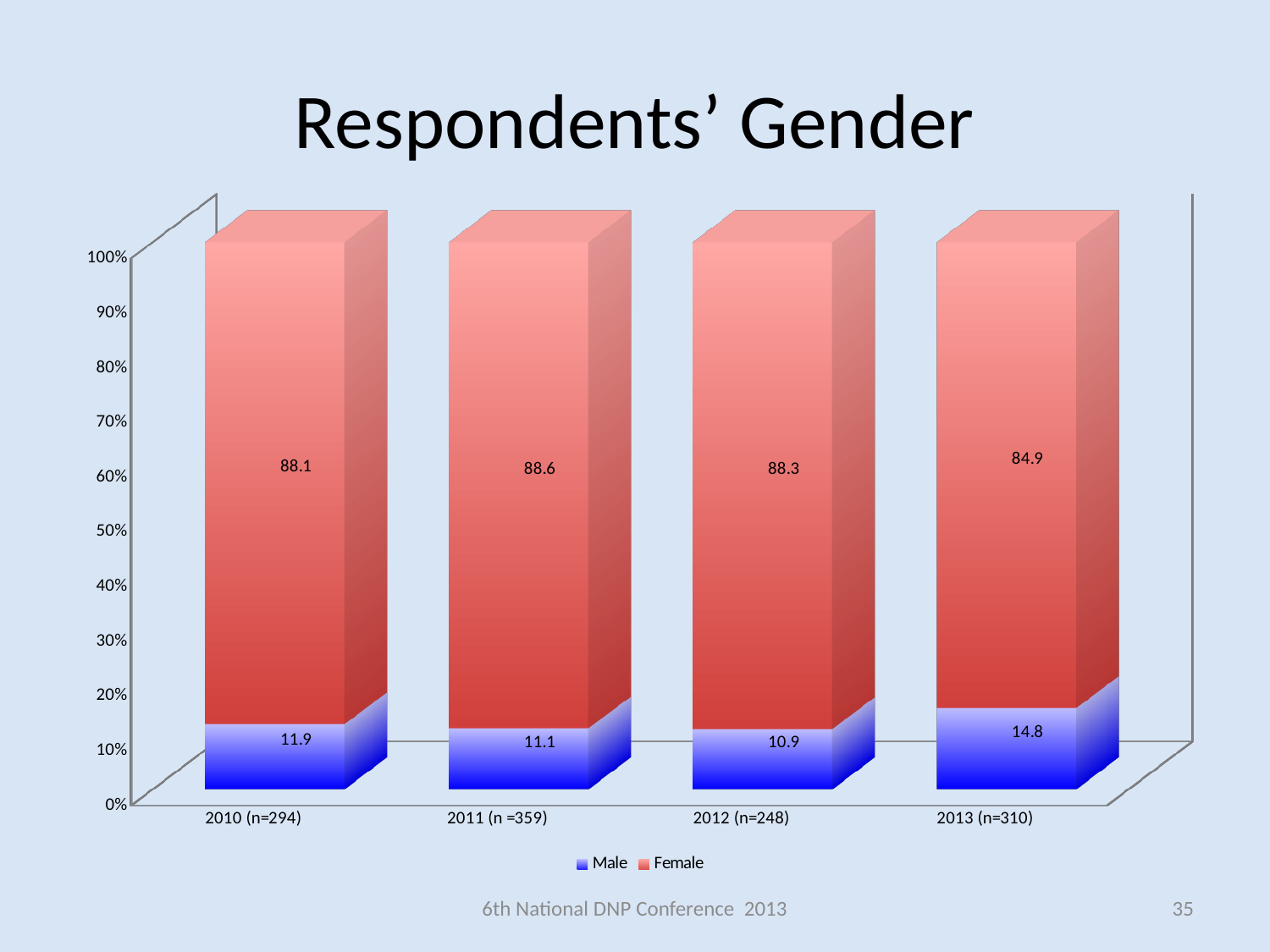
What is the difference between the Female and Male values for 2010 (n=294)? 76.2 What type of chart is shown on the slide? Stacked bar chart What is the Female value for 2013 (n=310)? 84.9 Is the Male value larger in 2011 (n =359) or in 2013 (n=310)? 2013 (n=310) What is the Male value for 2012 (n=248)? 10.9 Which year has the lowest Female value? 2013 (n=310) How many years are shown on the x axis? 4 What is the Female value for 2011 (n =359)? 88.6 Which year has the highest Male value? 2013 (n=310) What is the Male value for 2010 (n=294)? 11.9 How many series does the legend list? 2 Which year has the lowest Male value? 2012 (n=248)